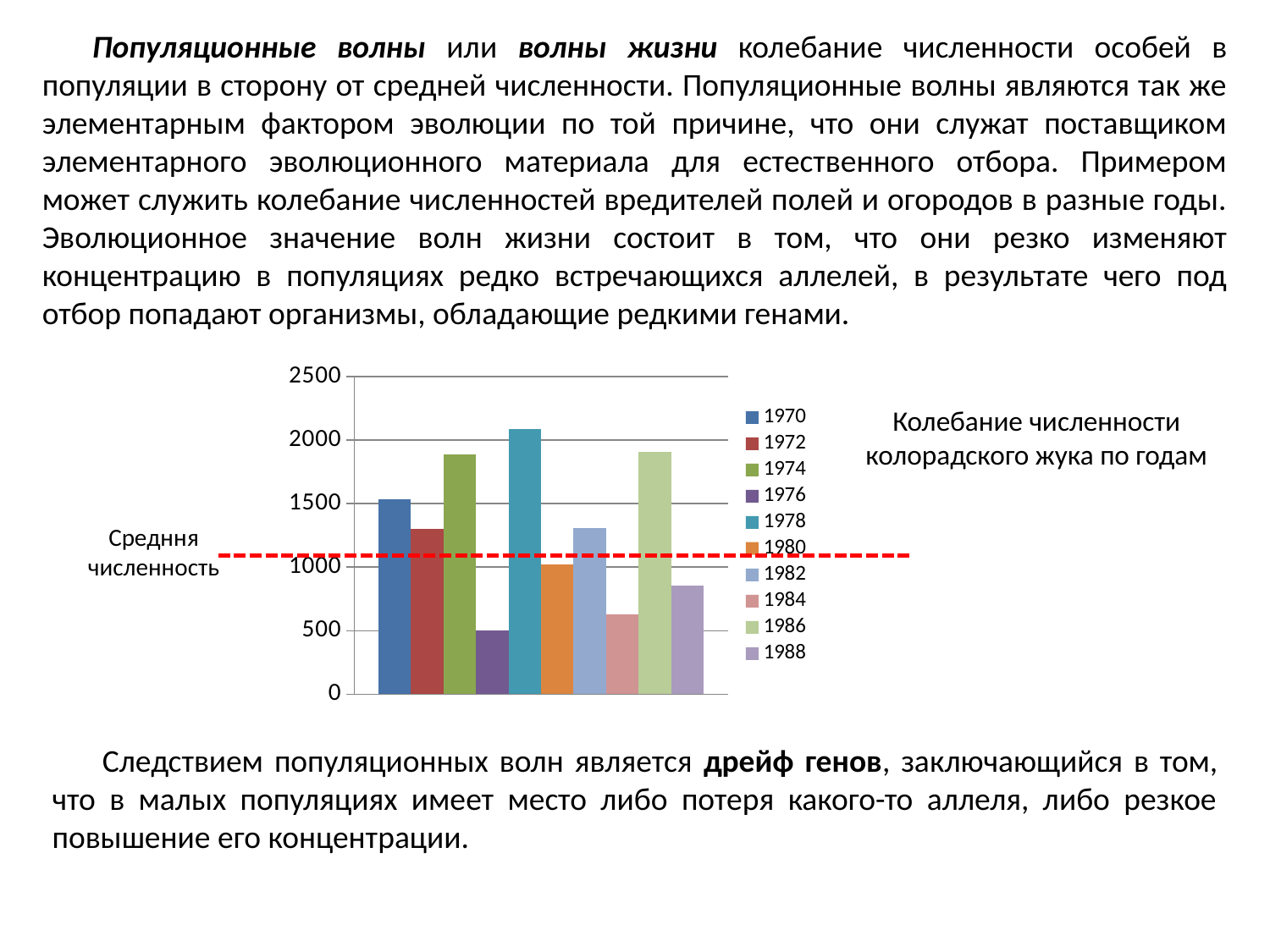
Which is larger, the value for 1974 or the value for 1976? 1974 What does the red dashed horizontal line across the chart represent, according to its label? Средння численность Which year has the highest value in the chart? 1978 Is the value for 1974 greater or less than 1500? greater What kind of chart is shown on the slide? bar chart Is the value for 1988 greater or less than 1000? less How many bars are plotted in the chart? 10 Is the value for 1978 greater or less than 2000? greater Which is larger, the value for 1986 or the value for 1988? 1986 Which year has the lowest value in the chart? 1976 How many series does the legend list? 10